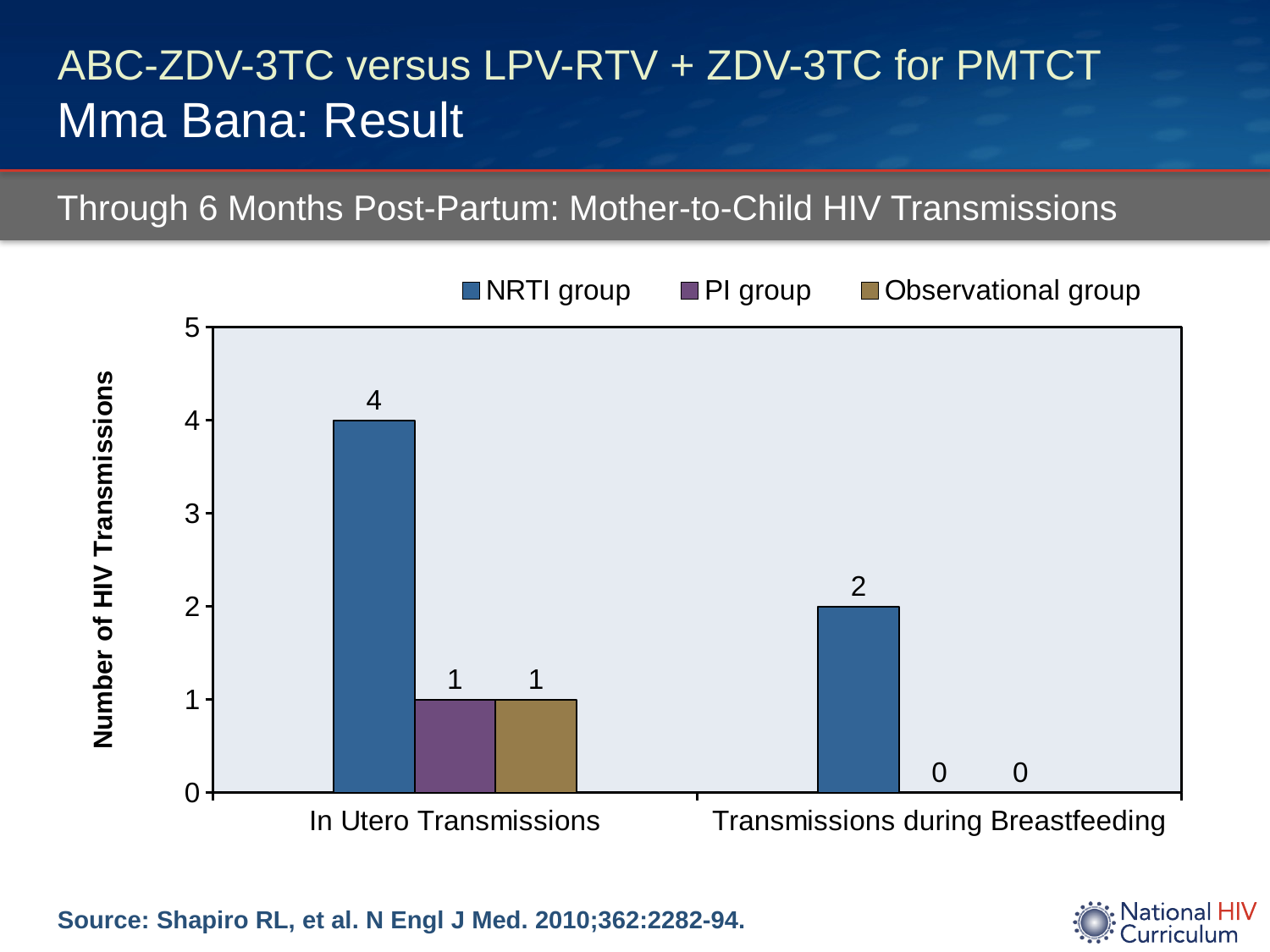
What is the label of the y axis? Number of HIV Transmissions How many series does the legend list? 3 How many transmissions during breastfeeding are shown for the NRTI group? 2 Which is larger: the NRTI group's in utero transmissions or the PI group's in utero transmissions? NRTI group's in utero transmissions How many transmissions during breastfeeding are shown for the Observational group? 0 How many HIV transmissions occurred in utero in the NRTI group? 4 Which group had the most in utero transmissions? NRTI group What colour represents the PI group in the chart? Purple What kind of chart is shown on the slide? Bar chart How many categories are shown on the x axis? 2 How many in utero transmissions are shown for the PI group? 1 What is the difference between the NRTI group's in utero transmissions and its transmissions during breastfeeding? 2